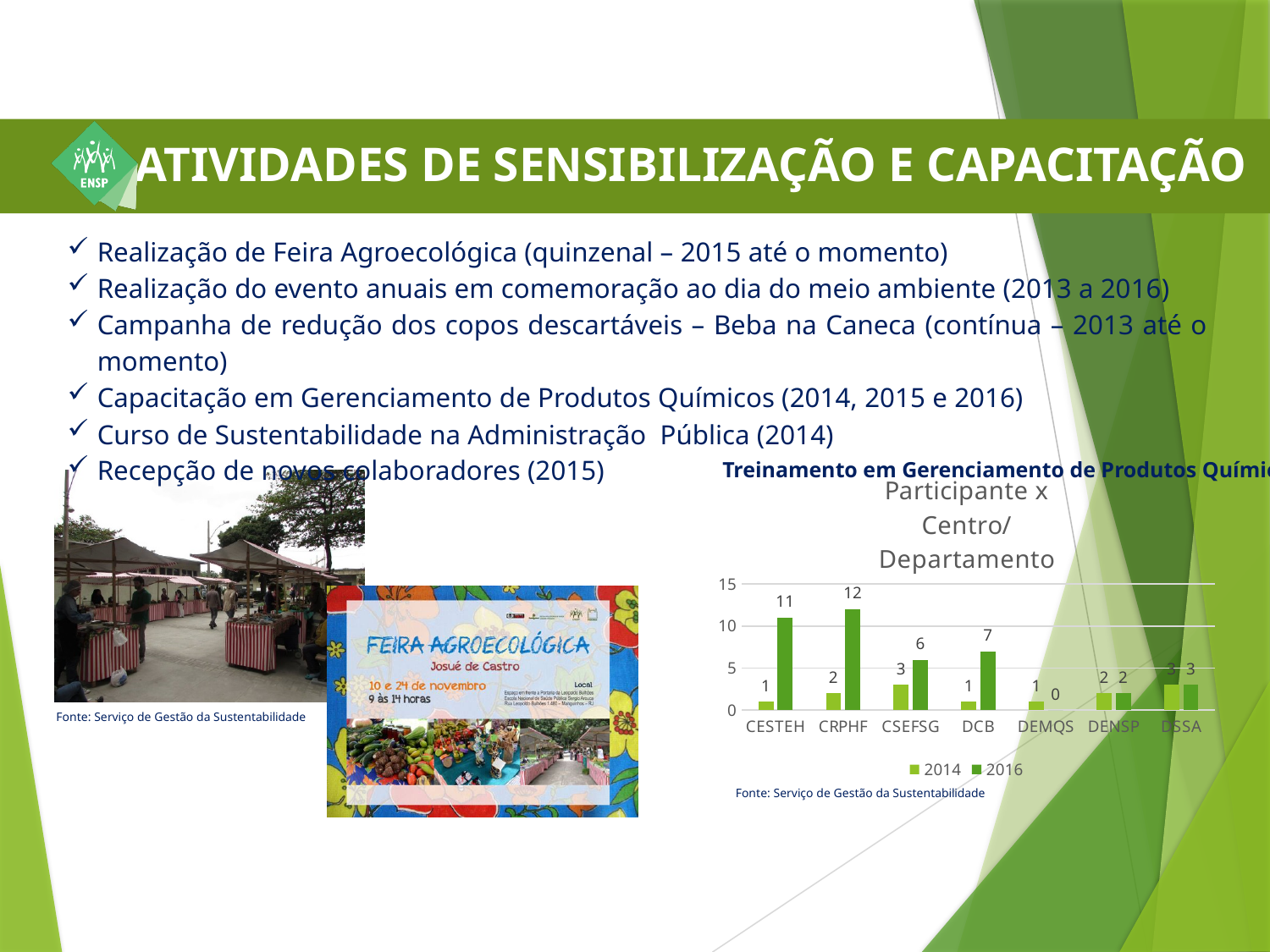
Is the 2016 value for CRPHF greater or less than 10? greater How many departments are shown on the x axis of the chart? 7 Which is larger for DCB, the 2014 value or the 2016 value? 2016 What is the difference between the 2016 and 2014 values for CESTEH? 10 What is the 2014 value for CSEFSG? 3 How many series does the chart legend list? 2 What is the 2016 value for CRPHF? 12 What is the title of the chart? Participante x Centro/Departamento What is the 2016 value for DEMQS? 0 Which department has the lowest 2016 value? DEMQS Which department has the highest 2016 value? CRPHF What type of chart is shown on the slide? bar chart